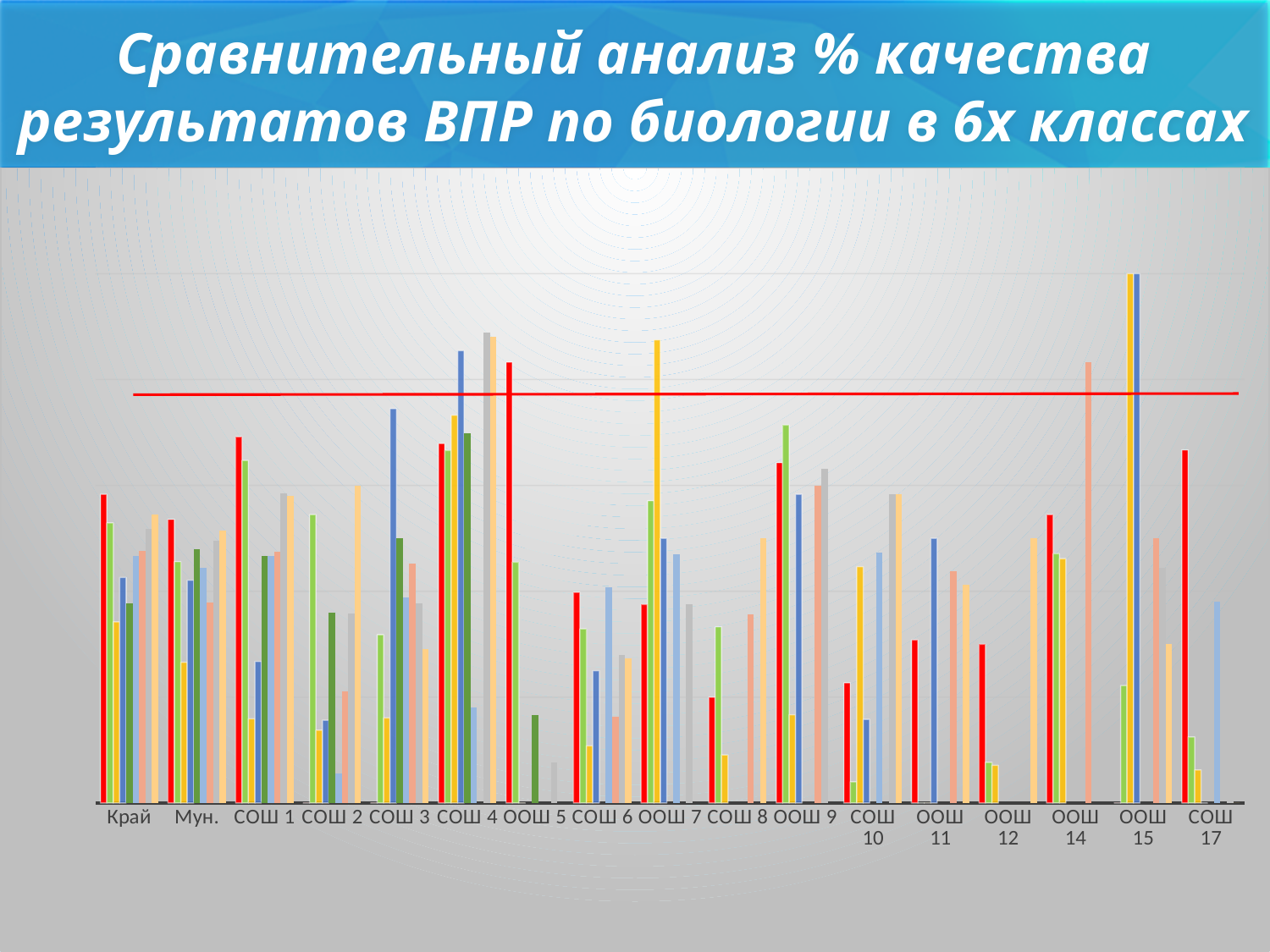
Is the red bar for Край or the red bar for СОШ 17 taller? СОШ 17 Among the red bars, which category has the tallest one? ООШ 5 What kind of chart is shown on the slide? bar chart What is the first category on the x axis of the chart? Край Is the red bar for СОШ 4 or the red bar for СОШ 6 taller? СОШ 4 How many categories are shown along the x axis of the chart? 17 Is the red bar for Мун. or the red bar for СОШ 1 taller? СОШ 1 Which category contains the tallest bar in the chart? ООШ 15 What is the title of the slide's chart? Сравнительный анализ % качества результатов ВПР по биологии в 6х классах